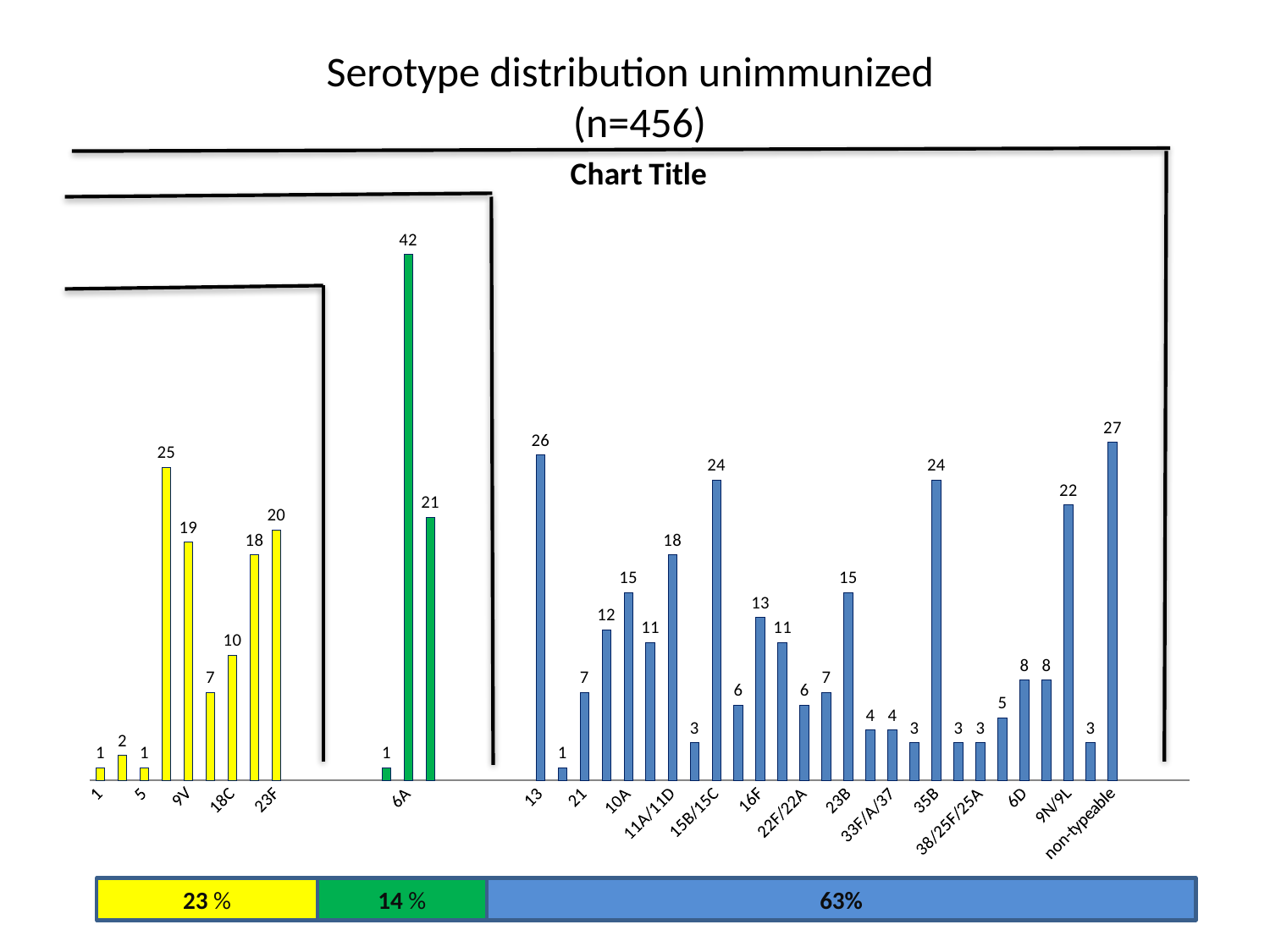
What is the value for serotype 35B? 24 What type of chart is shown on the slide? bar chart What is the value for serotype 23F? 20 What is the value for serotype 9V? 19 What is the sample size (n) given in the slide title? 456 Which serotype has the highest value in the chart? 6A What percentage is shown in the yellow section of the bar below the chart? 23 % What is the difference between the values for 13 and 21? 19 Which has a larger value, 9N/9L or 16F? 9N/9L What is the difference between the values for 6A and non-typeable? 15 What is the value for non-typeable? 27 What is the value for serotype 6A? 42